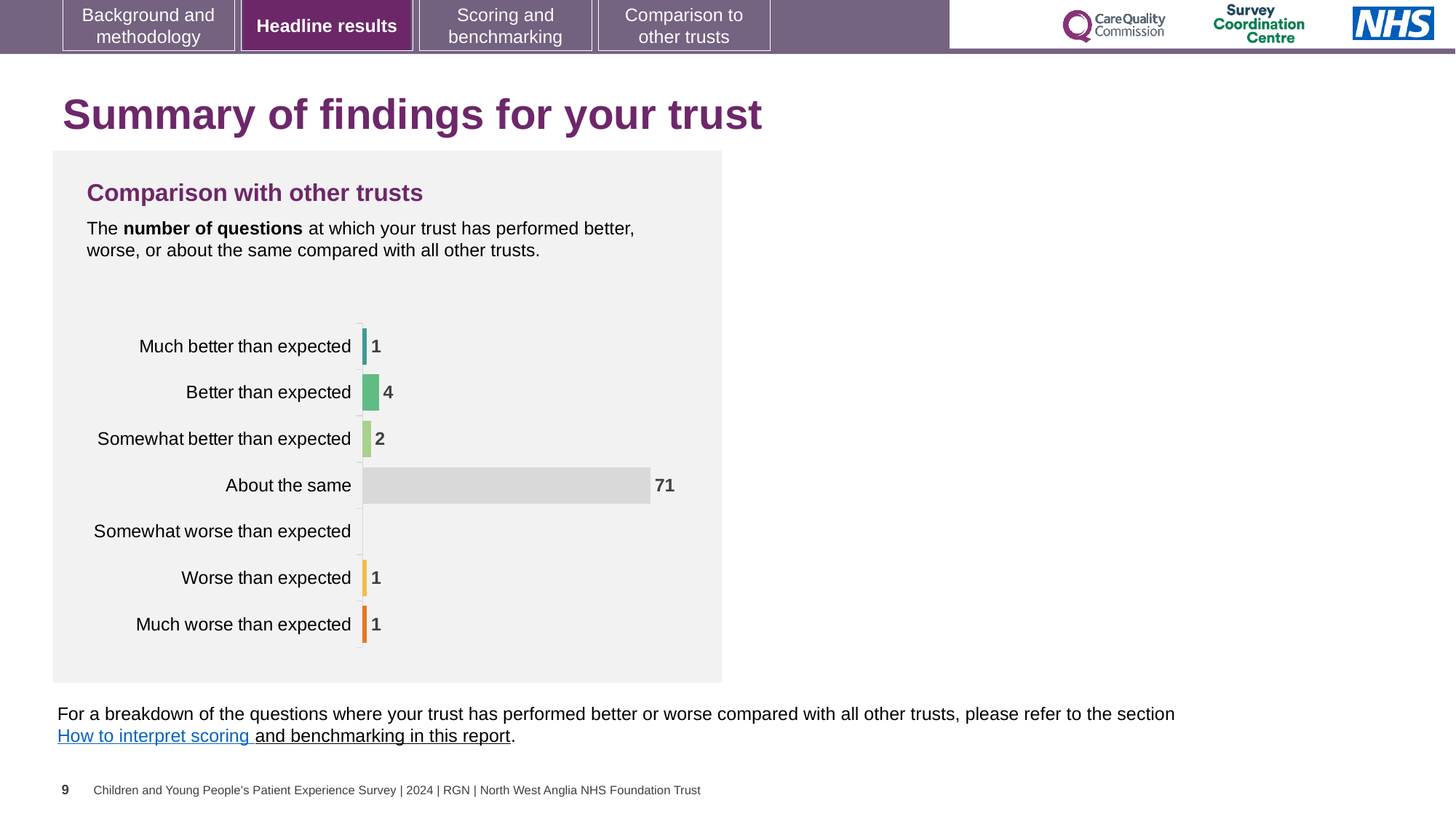
Which category has no bar shown (a value of zero)? Somewhat worse than expected How many categories are shown on the chart? 7 What is the value for 'Better than expected'? 4 Which category has the highest number of questions? About the same What is the title of the chart section? Comparison with other trusts What is the value for 'Much worse than expected'? 1 How many questions are in the 'About the same' category? 71 What is the value for 'Somewhat better than expected'? 2 What is the difference between 'Better than expected' and 'Somewhat better than expected'? 2 What kind of chart is shown on the slide? Bar chart What is the difference between 'About the same' and 'Better than expected'? 67 Which is larger, 'Better than expected' or 'Much better than expected'? Better than expected